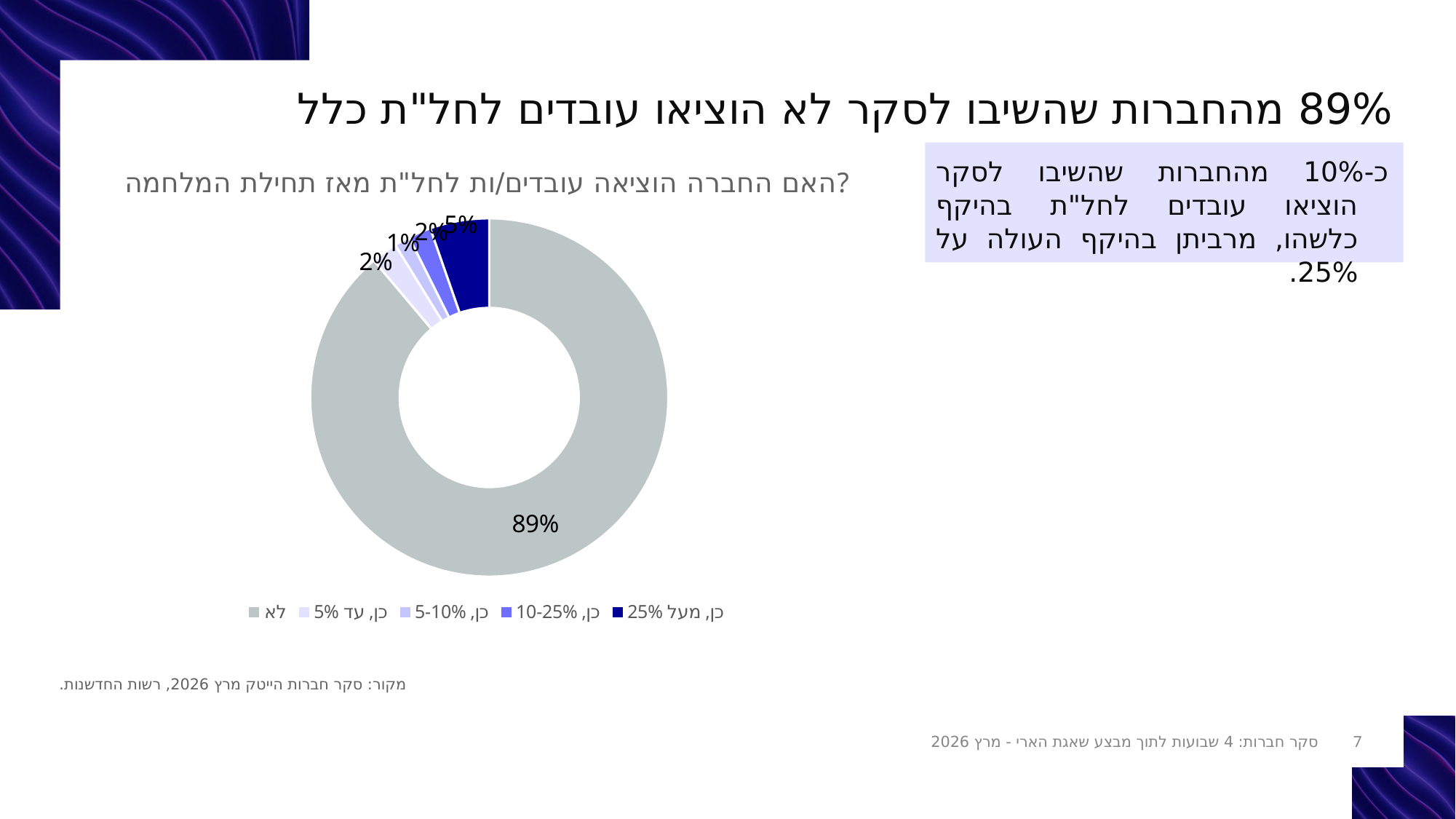
What is the title of the chart? האם החברה הוציאה עובדים/ות לחל"ת מאז תחילת המלחמה? How many categories does the chart's legend list? 5 Which is larger: the "כן, מעל 25%" slice or the "כן, 10-25%" slice? כן, מעל 25% What is the difference in percentage points between the "לא" slice and the "כן, מעל 25%" slice? 84 percentage points Which category has the smallest slice in the chart? כן, 5-10% What kind of chart is shown on the slide? Donut (pie) chart Which category has the largest slice in the chart? לא What is the value shown for the "כן, מעל 25%" slice? 5% What share of the donut chart is the "לא" slice? 89% What colour is the "לא" slice in the chart? Grey What is the value shown for the "כן, 10-25%" slice? 2% What is the value shown for the "כן, 5-10%" slice? 1%